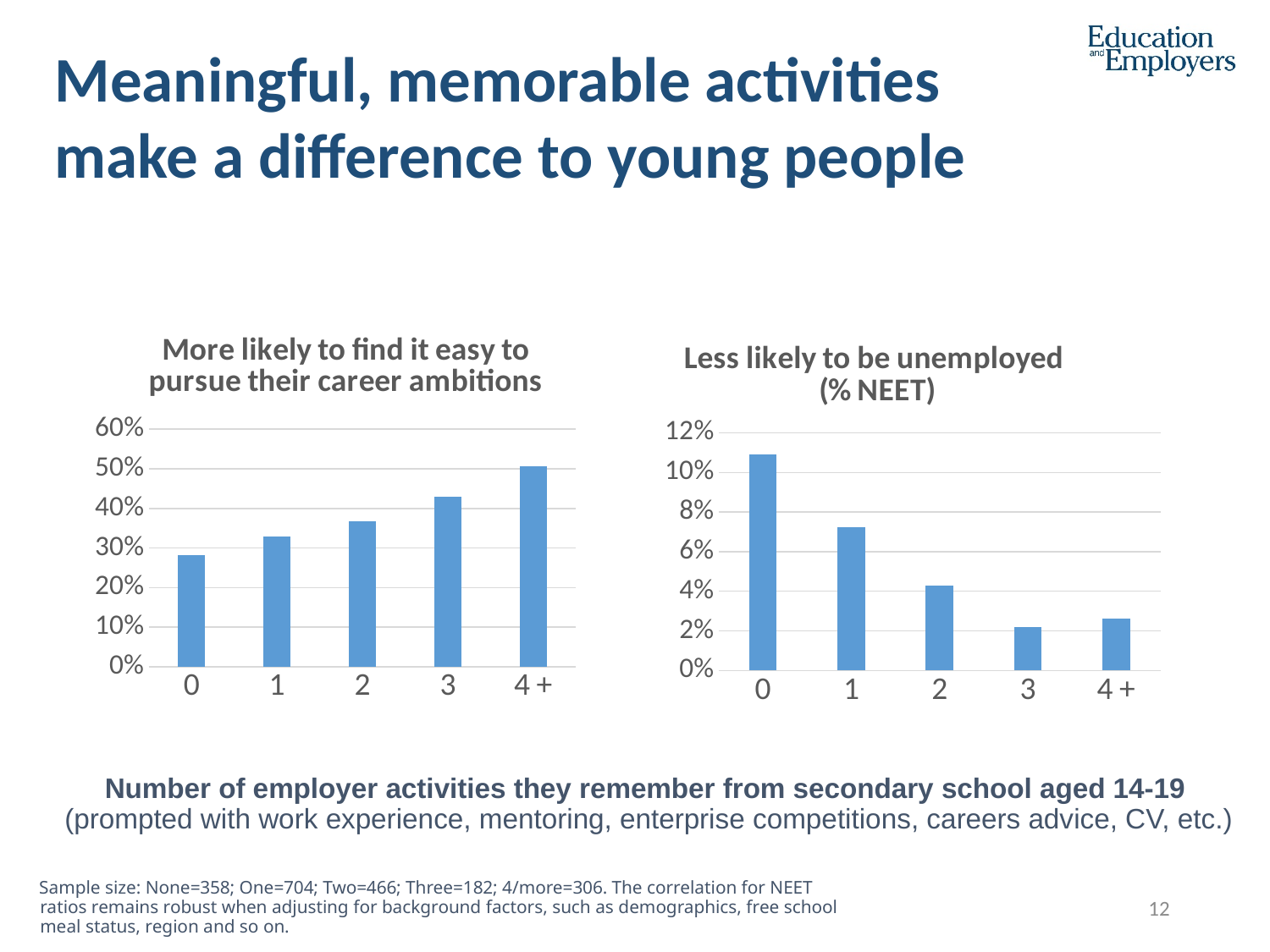
In the right chart, 'Less likely to be unemployed (% NEET)', which category has the highest value? 0 In the right chart, 'Less likely to be unemployed (% NEET)', is the value for 1 greater or less than 8%? less How many categories are shown on the x axis of the left chart, 'More likely to find it easy to pursue their career ambitions'? 5 In the right chart, 'Less likely to be unemployed (% NEET)', is the value for 0 greater or less than 10%? greater What is the title of the right chart? Less likely to be unemployed (% NEET) In the right chart, 'Less likely to be unemployed (% NEET)', which is larger, the value for 0 or the value for 2? 0 In the left chart, 'More likely to find it easy to pursue their career ambitions', do the values rise or fall as the number of activities increases from 0 to 4+? rise In the left chart, 'More likely to find it easy to pursue their career ambitions', which category has the lowest value? 0 In the left chart, 'More likely to find it easy to pursue their career ambitions', is the value for 3 greater or less than 40%? greater In the left chart, 'More likely to find it easy to pursue their career ambitions', which category has the highest value? 4+ What kind of chart is the left chart, 'More likely to find it easy to pursue their career ambitions'? bar chart